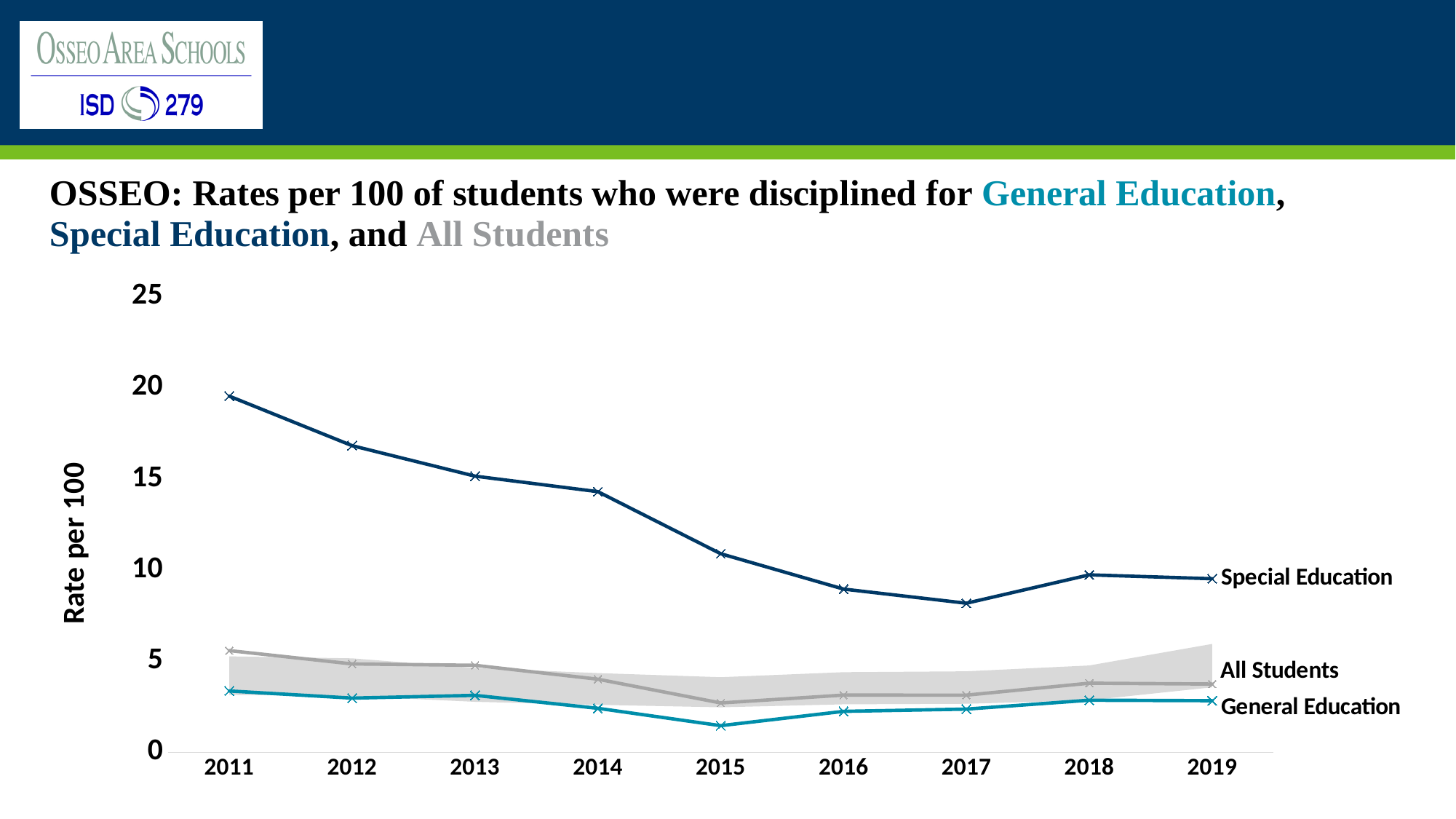
Which series has the lowest values across all years? General Education What is the label on the y axis? Rate per 100 Which series has the highest values across all years? Special Education What kind of chart is shown on the slide? line chart Does the Special Education rate generally rise or fall from 2011 to 2017? fall In which year is the Special Education rate highest? 2011 How many years are plotted along the x axis? 9 Is the General Education value for 2015 greater or less than 5? less In which year is the Special Education rate lowest? 2017 Is the Special Education value for 2011 greater or less than 15? greater Is the Special Education value for 2017 greater or less than 10? less